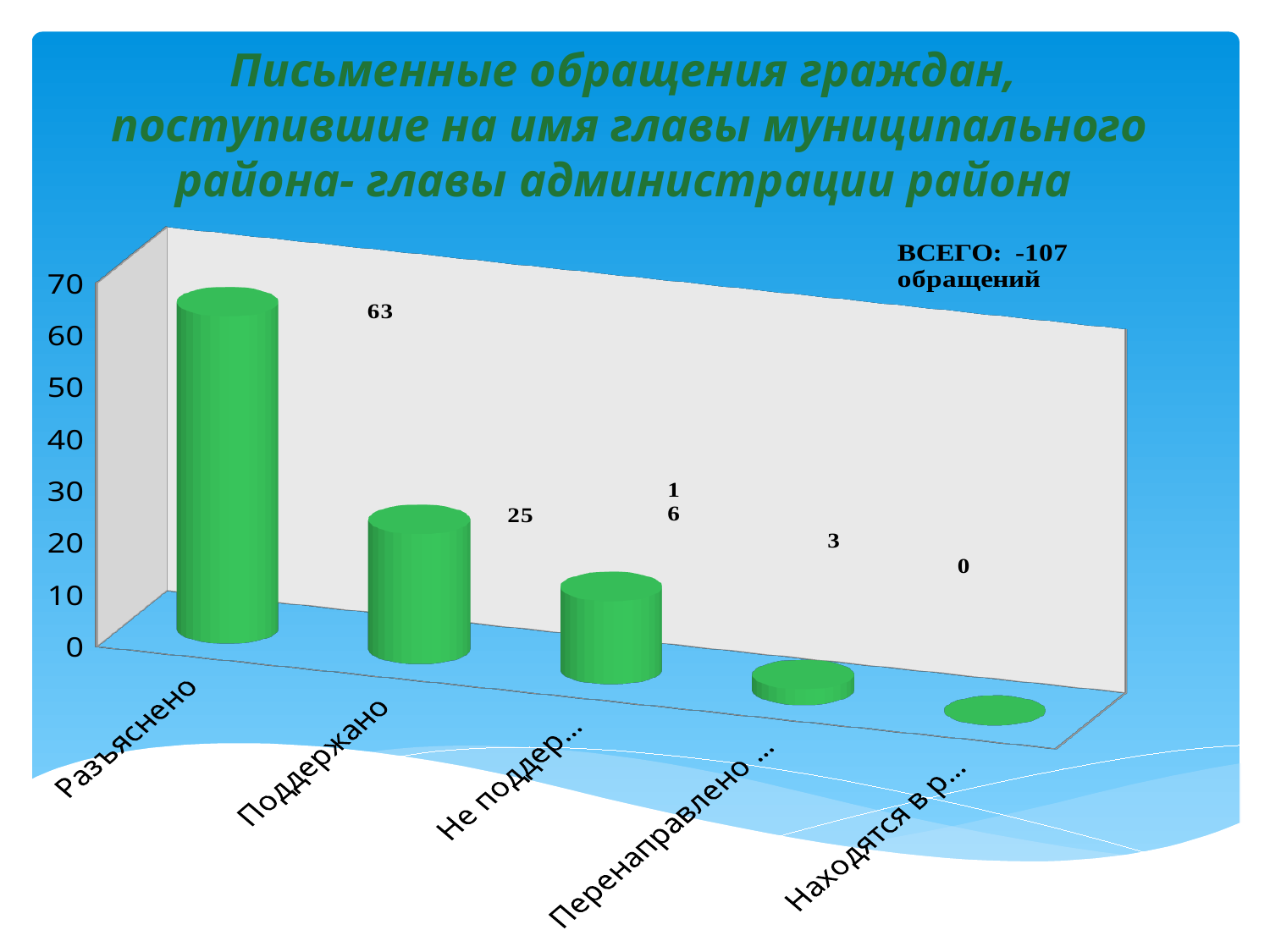
What is the value for the last category, Находятся в р...? 0 What is the value for Разъяснено? 63 Which category has the lowest value? Находятся в р... Which category has the highest value? Разъяснено What is the value for the fourth category, Перенаправлено ...? 3 What is the difference between the values for Разъяснено and Поддержано? 38 Which is larger, the value for Поддержано or the value for Перенаправлено ...? Поддержано How many categories are shown on the chart? 5 Do the values rise or fall from left to right along the x axis? fall Is the value for Разъяснено greater or less than 50? greater What is the value for Поддержано? 25 What kind of chart is shown on the slide? bar chart